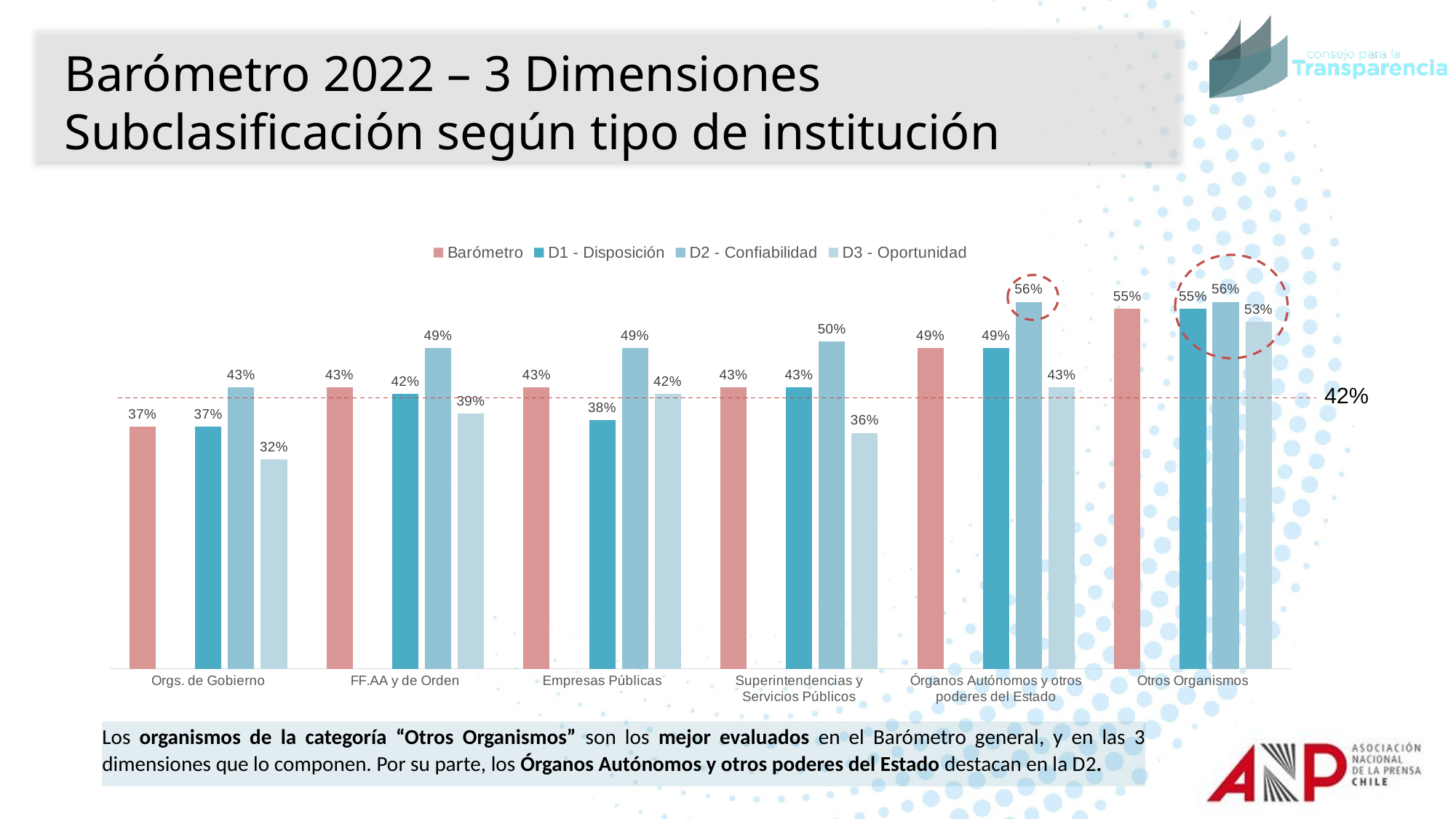
What is the D3 - Oportunidad value for Orgs. de Gobierno? 32% Which is larger for FF.AA y de Orden: the D1 - Disposición value or the D2 - Confiabilidad value? D2 - Confiabilidad What is the Barómetro value for Otros Organismos? 55% How many series does the legend list? 4 Which category has the highest Barómetro value? Otros Organismos What is the difference between the D2 - Confiabilidad and D3 - Oportunidad values for Órganos Autónomos y otros poderes del Estado? 13% What is the D1 - Disposición value for Empresas Públicas? 38% What is the D2 - Confiabilidad value for Superintendencias y Servicios Públicos? 50% Which category has the lowest D3 - Oportunidad value? Orgs. de Gobierno What value does the dashed horizontal reference line mark? 42% What kind of chart is shown on the slide? Bar chart How many institution categories are shown on the x axis? 6